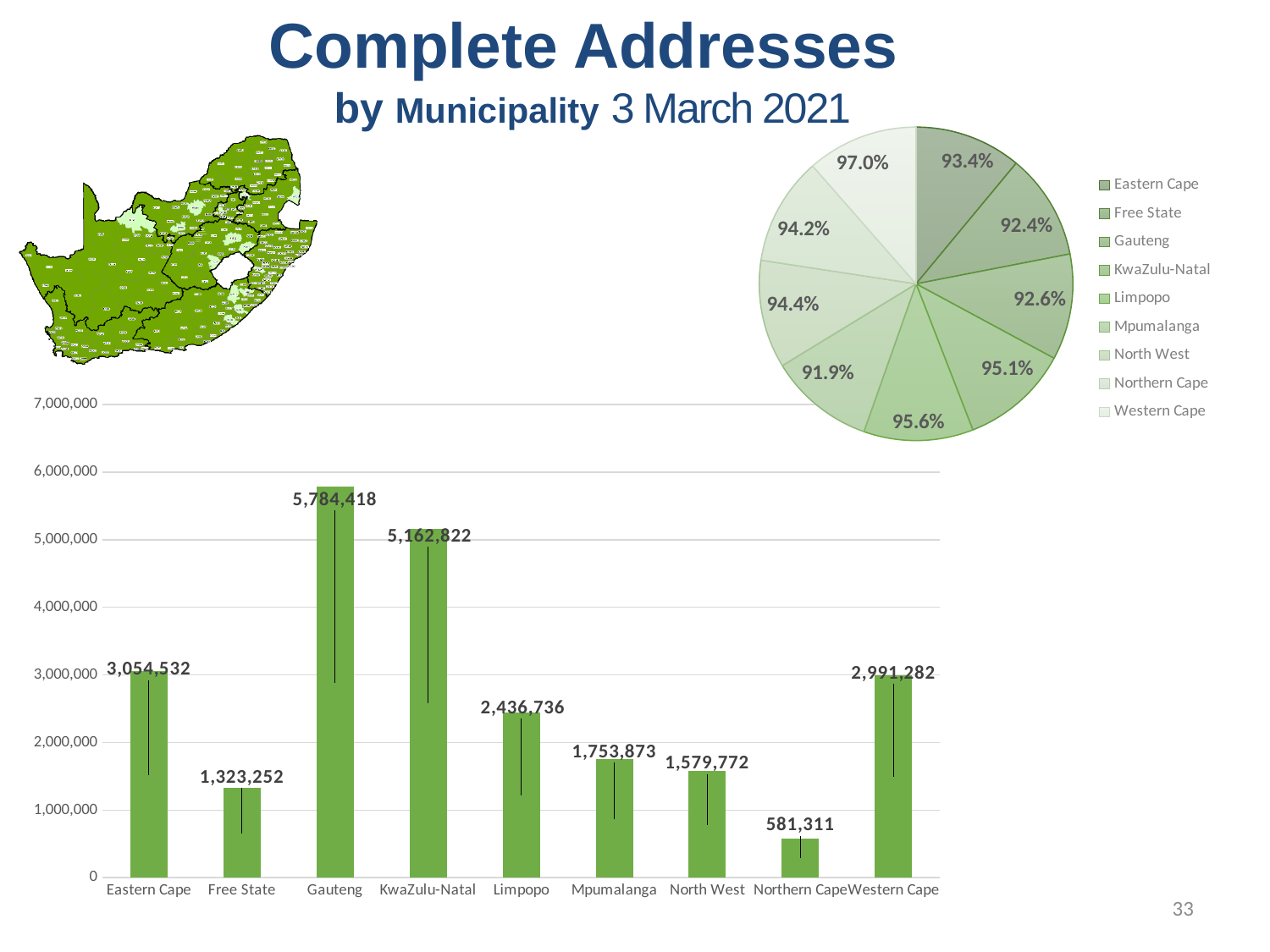
In the bar chart, what is the difference between the values for Gauteng and KwaZulu-Natal? 621,596 In the pie chart, what is the highest percentage shown on any slice? 97.0% In the bar chart, which province has the lowest value? Northern Cape How many entries does the legend of the pie chart list? 9 In the bar chart, what is the value for Northern Cape? 581,311 What kind of chart is the chart at the bottom of the slide? bar chart In the bar chart, what is the value for Gauteng? 5,784,418 How many provinces are shown on the x axis of the bar chart? 9 In the bar chart, what is the value for Limpopo? 2,436,736 In the bar chart, which province has the highest value? Gauteng In the bar chart, is the value for Free State greater or less than 2,000,000? less In the bar chart, which is larger, the value for Mpumalanga or the value for North West? Mpumalanga